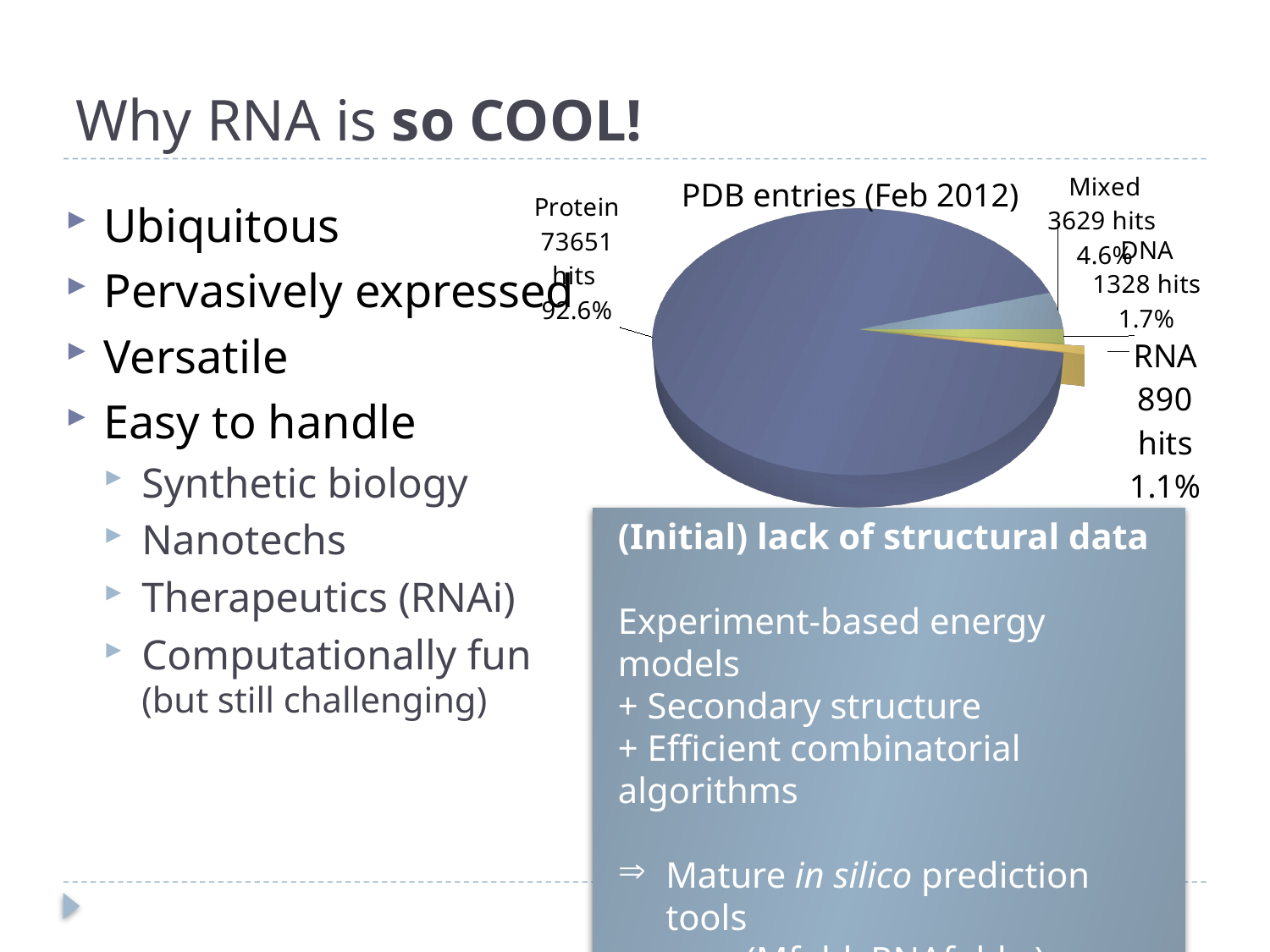
Which category has the largest slice of the pie? Protein What kind of chart is shown on the slide? pie chart What is the difference in hits between the Mixed and DNA categories? 2301 hits How many hits does the Protein slice represent? 73651 hits How many slices does the pie chart have? 4 What percentage of PDB entries is DNA? 1.7% Which has more hits, DNA or RNA? DNA How many hits does the RNA slice represent? 890 hits How many hits does the Mixed slice represent? 3629 hits What is the title of the chart? PDB entries (Feb 2012) Which category has the smallest slice of the pie? RNA What share of the pie does Protein take? 92.6%